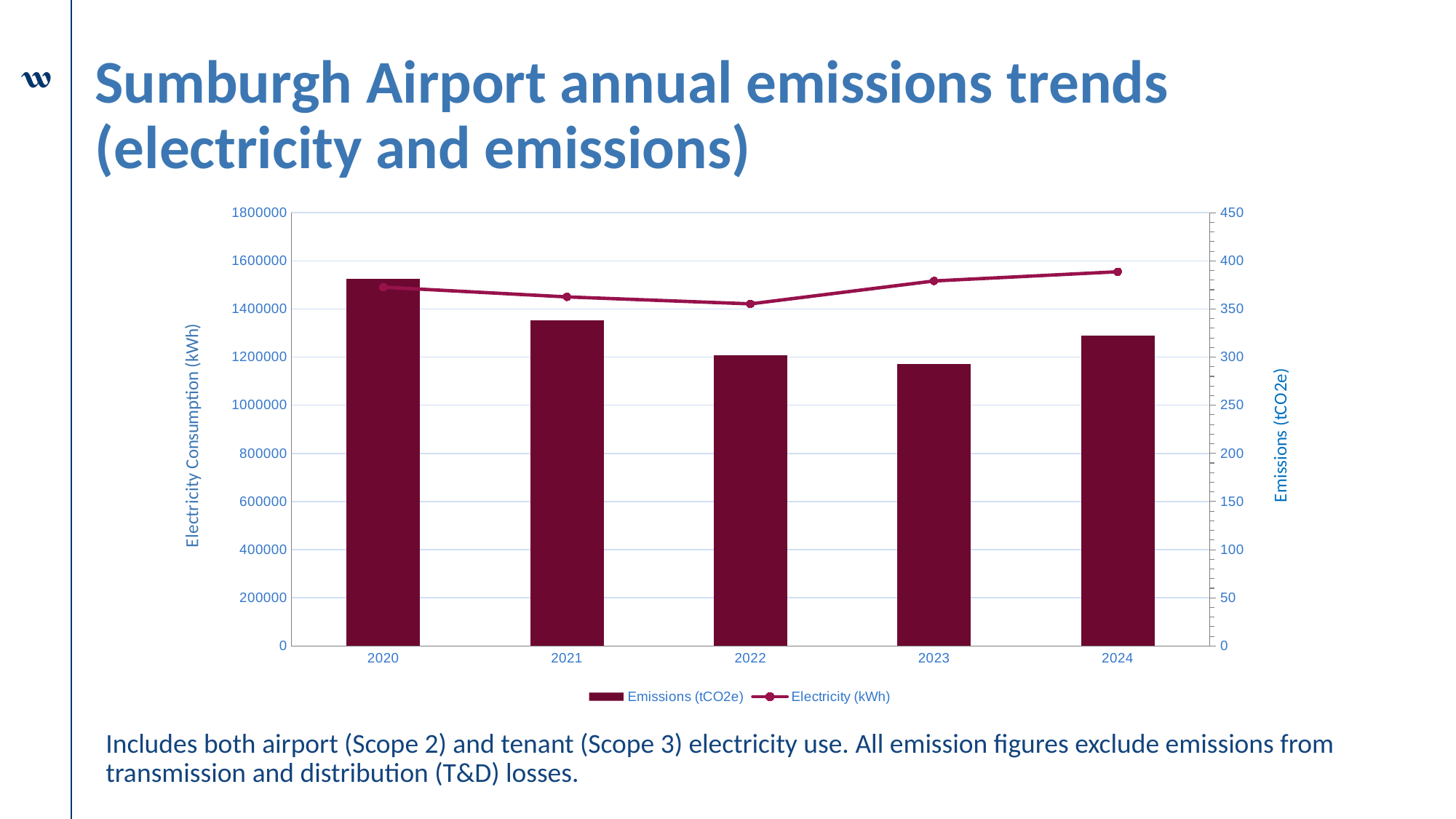
How do the Emissions (tCO2e) bars change from 2020 to 2023? They fall each year In which year is the Electricity (kWh) line at its highest point? 2024 What kind of chart is shown on the slide? A combined bar and line chart How many series does the chart legend list? 2 Is the Emissions (tCO2e) value for 2020 greater or less than 350? greater Which year has the tallest Emissions (tCO2e) bar? 2020 In which year is the Electricity (kWh) line at its lowest point? 2022 Is the Electricity (kWh) value for 2024 greater or less than 1600000? less Which year has the taller Emissions (tCO2e) bar, 2021 or 2024? 2021 How many years are shown on the x axis of the chart? 5 Which series is drawn as a line with markers according to the legend? Electricity (kWh) Which year has the shortest Emissions (tCO2e) bar? 2023